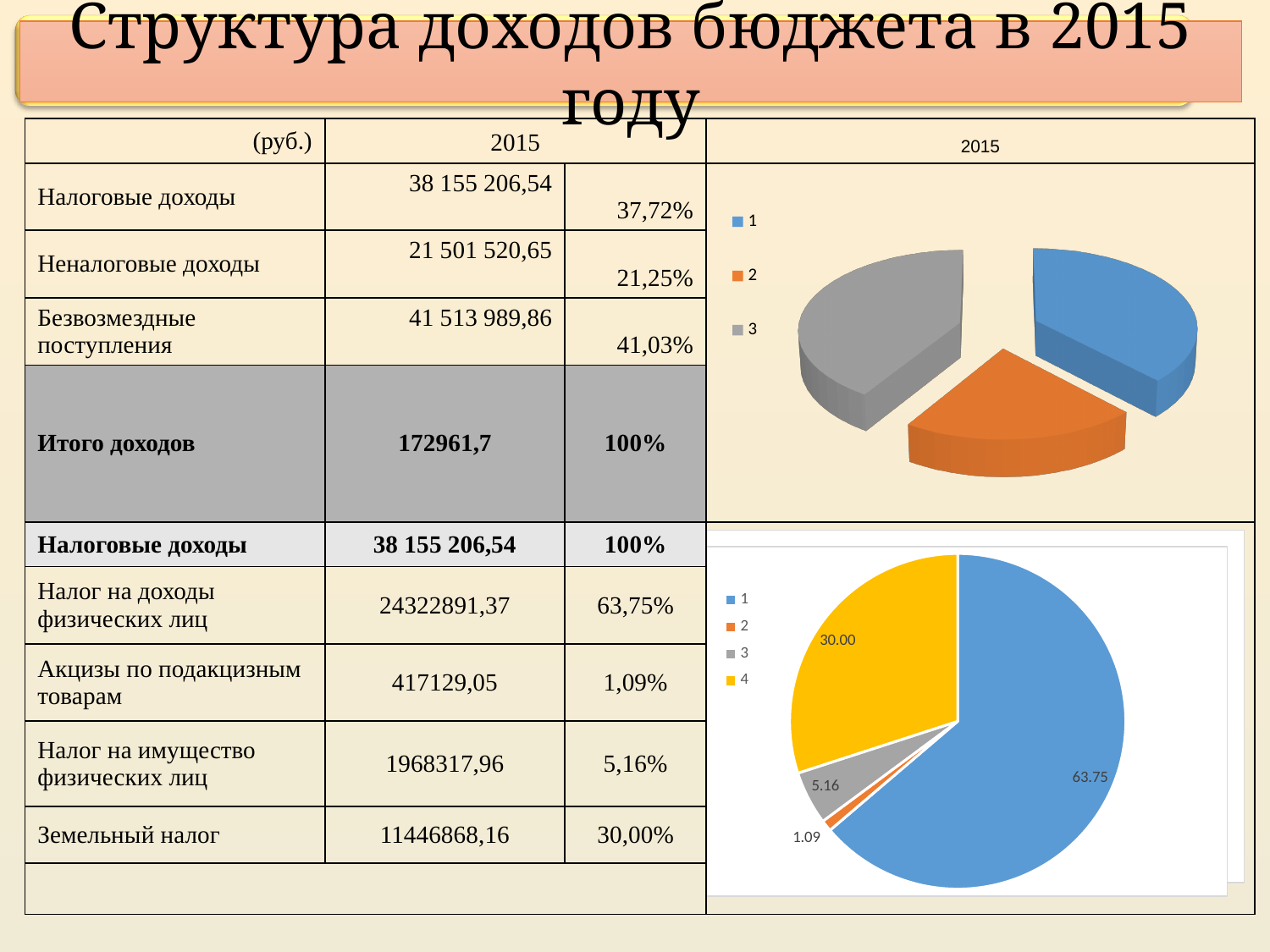
In the bottom chart, which is larger: the grey slice or the orange slice? grey slice What kind of chart is the bottom chart on the slide? pie chart What kind of chart is the top chart titled "2015"? pie chart In the bottom chart, what is the data label on the orange slice? 1.09 In the top chart titled "2015", which legend entry corresponds to the smallest slice? 2 In the bottom chart, what is the data label on the largest (blue) slice? 63.75 How many entries does the legend of the bottom chart list? 4 In the bottom chart, what is the data label on the grey slice? 5.16 In the bottom chart, which slice has the smallest value? orange (1.09) In the bottom chart, what is the difference between the blue slice (63.75) and the yellow slice (30.00)? 33.75 In the bottom chart, what is the data label on the yellow slice? 30.00 How many entries does the legend of the top chart titled "2015" list? 3